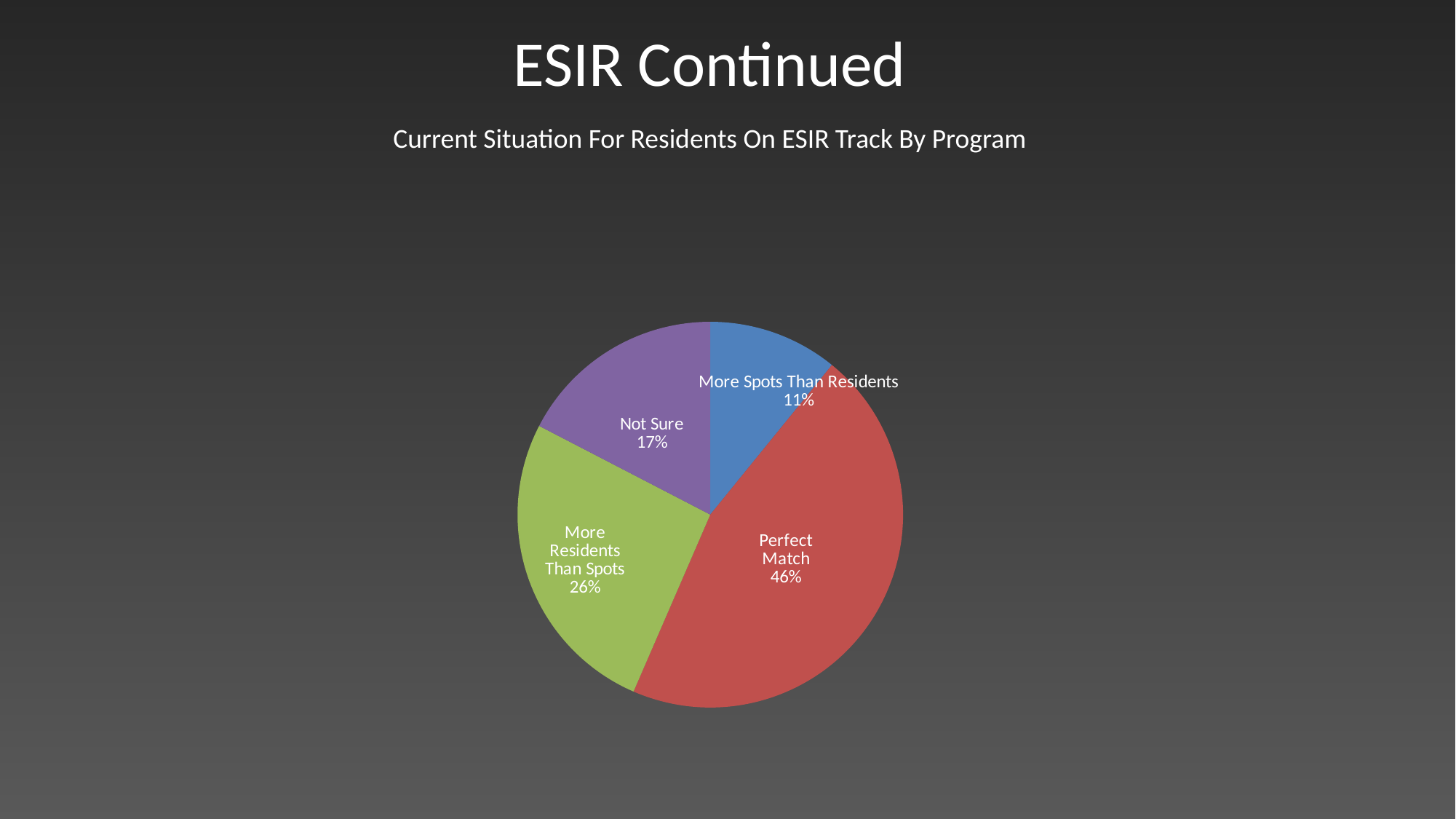
Which slice of the pie is the smallest? More Spots Than Residents What share of the pie is labelled Perfect Match? 46% What colour is the Perfect Match slice? Red What is the difference in percentage points between the Perfect Match slice and the More Residents Than Spots slice? 20 What share of the pie is labelled Not Sure? 17% What share of the pie is labelled More Spots Than Residents? 11% What kind of chart is shown on the slide? Pie chart What is the title of the chart? Current Situation For Residents On ESIR Track By Program How many slices does the pie chart have? 4 Which slice is larger, Not Sure or More Spots Than Residents? Not Sure Which slice of the pie is the largest? Perfect Match